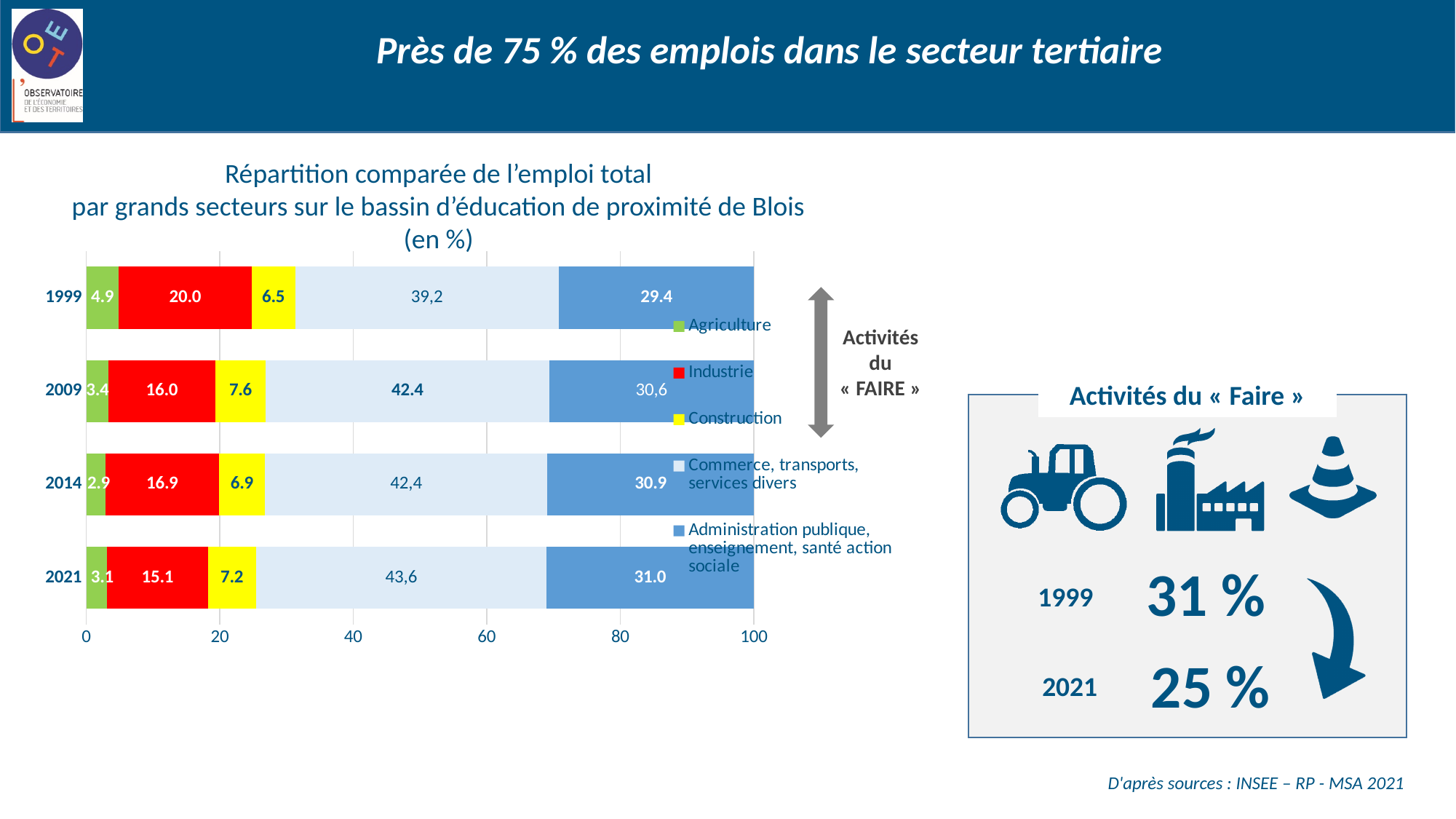
In which year is the Industrie share the highest? 1999 What kind of chart is shown on the slide? Stacked bar chart What is the value for Commerce, transports, services divers in 2009? 42.4 What is the difference between the Industrie value in 1999 and in 2021? 4.9 In which year is the Agriculture share the lowest? 2014 What is the value for Administration publique, enseignement, santé action sociale in 2014? 30.9 How many years are shown on the chart? 4 What is the value for Industrie in 1999? 20.0 Does the Administration publique, enseignement, santé action sociale share rise or fall from 1999 to 2021? Rise Which year has the larger Construction value, 2009 or 2021? 2009 What is the value for Agriculture in 2021? 3.1 How many series does the legend list? 5